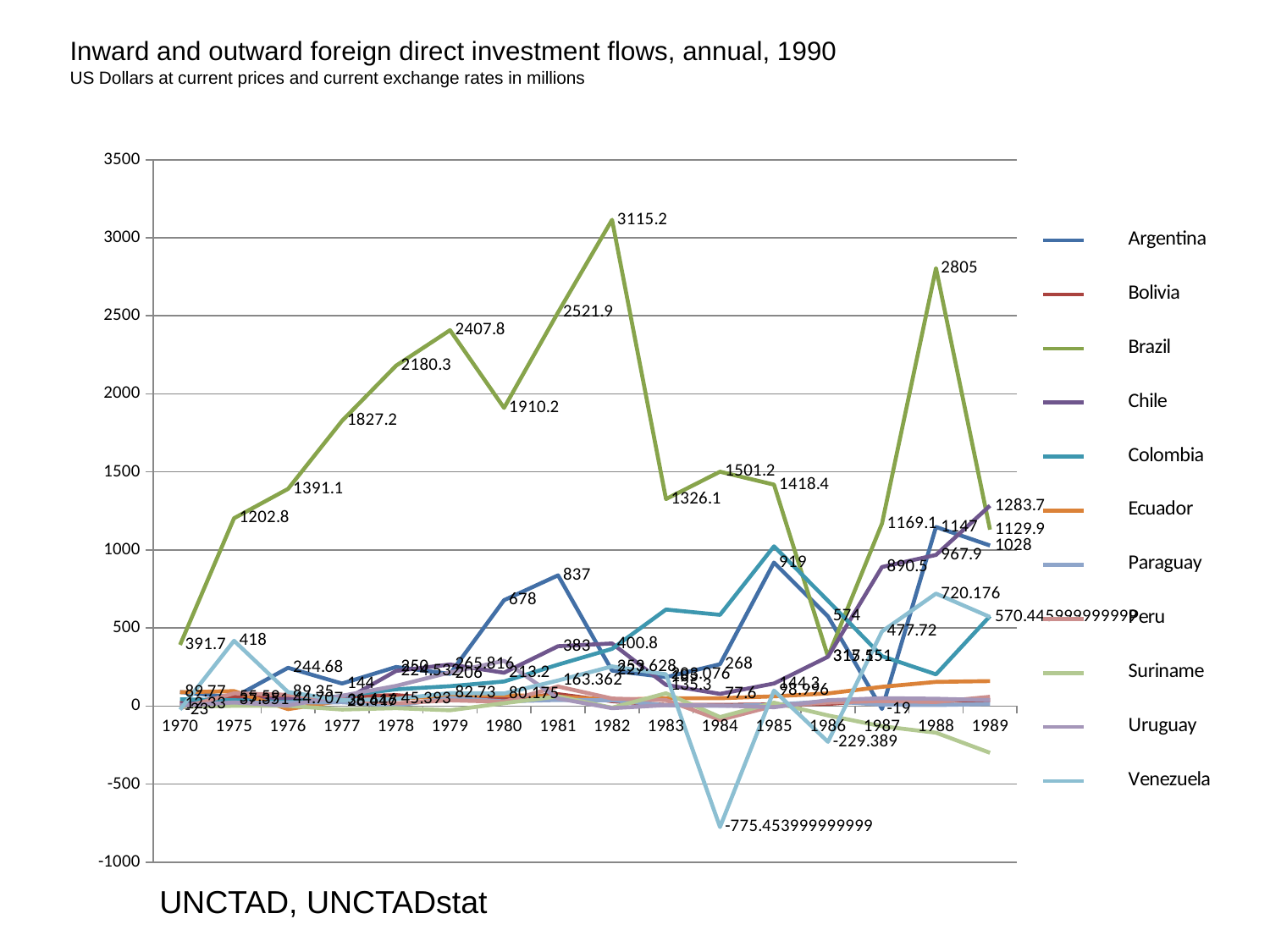
Does Brazil's value rise or fall from 1970 to 1979? Rise Which is larger for Brazil: the value in 1979 or the value in 1981? 1981 What is the value for Brazil in 1982? 3115.2 What is the difference between Brazil's values in 1982 and 1988? 310.2 How many series does the legend list? 11 What is the value for Chile in 1989? 1283.7 What is the value for Brazil in 1988? 2805 What is the value for Argentina in 1981? 837 In which year does Brazil reach its highest value? 1982 What kind of chart is shown on the slide? Line chart Is the value for Colombia in 1983 greater or less than 500? greater Which series has the lowest value on the chart, and in which year? Venezuela, 1984